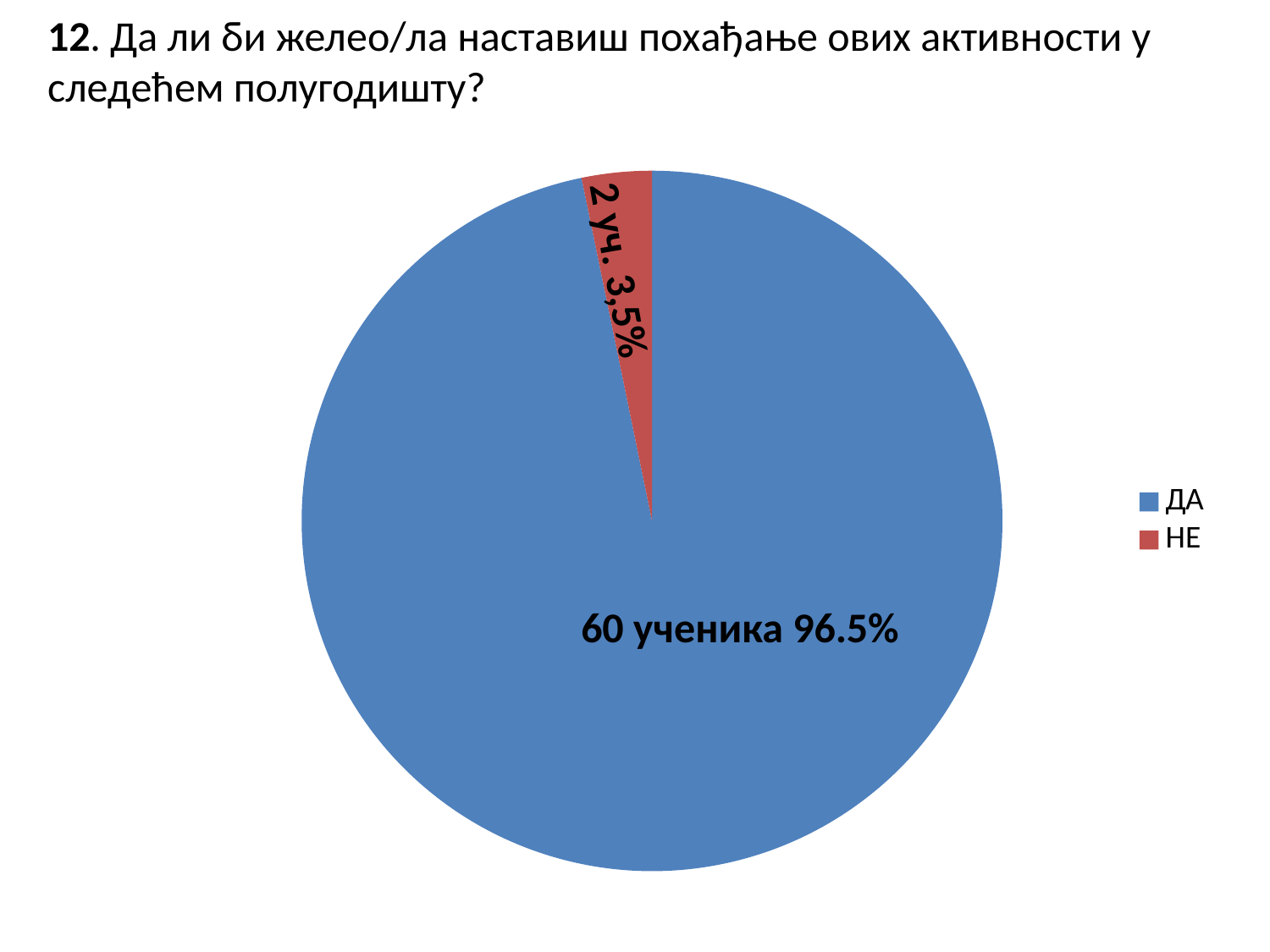
What colour is the ДА slice? blue Which is larger, the ДА slice or the НЕ slice? ДА How many students (ученика) are in the ДА slice? 60 What percentage is shown for the НЕ slice? 3,5% What percentage is shown for the ДА slice? 96.5% How many entries does the legend list? 2 How many more students answered ДА than НЕ? 58 Which category has the smallest slice of the pie? НЕ Which category has the largest slice of the pie? ДА How many slices does the pie chart have? 2 What kind of chart is shown on the slide? pie chart How many students are in the НЕ slice? 2